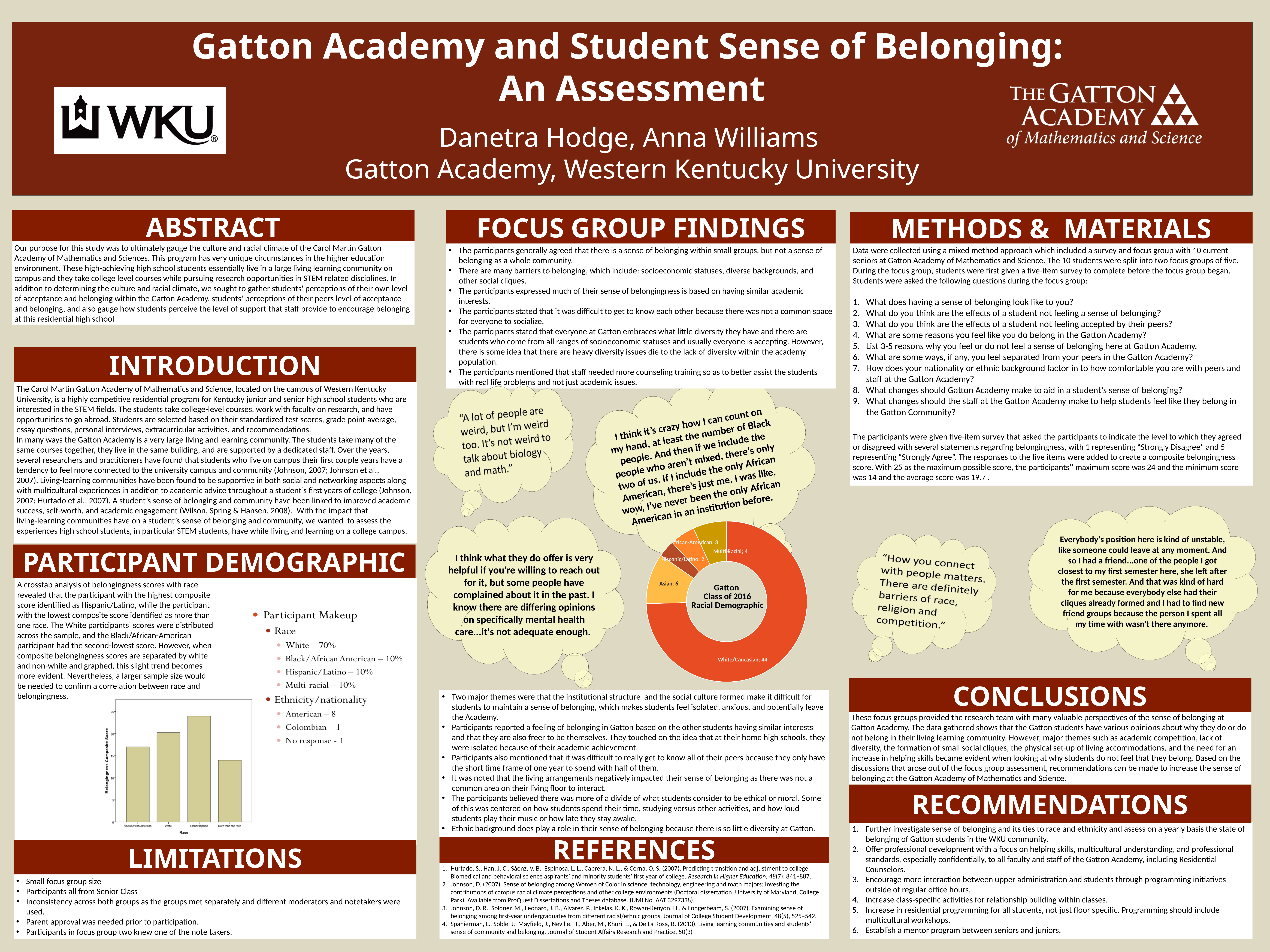
What kind of chart is the Gatton Class of 2016 Racial Demographic chart? Donut (pie) chart How many categories are shown in the Gatton Class of 2016 Racial Demographic chart? 5 In the Gatton Class of 2016 Racial Demographic chart, what is the difference between the White/Caucasian and Asian values? 38 In the Belongingness Composite Score bar chart in the Participant Demographic section, which race has the highest score? Latino/Hispanic In the Gatton Class of 2016 Racial Demographic chart, what is the value for White/Caucasian? 44 In the Gatton Class of 2016 Racial Demographic chart, which category has the largest value? White/Caucasian In the Gatton Class of 2016 Racial Demographic chart, which is larger, African-American or Multi-Racial? Multi-Racial In the Gatton Class of 2016 Racial Demographic chart, what is the value for Asian? 6 In the Gatton Class of 2016 Racial Demographic chart, which category has the smallest value? Hispanic/Latino In the Gatton Class of 2016 Racial Demographic chart, what is the value for Multi-Racial? 4 In the Belongingness Composite Score bar chart, is the value for More than one race greater or less than 15? less In the Belongingness Composite Score bar chart, which is larger, the score for White or for Black/African American? White